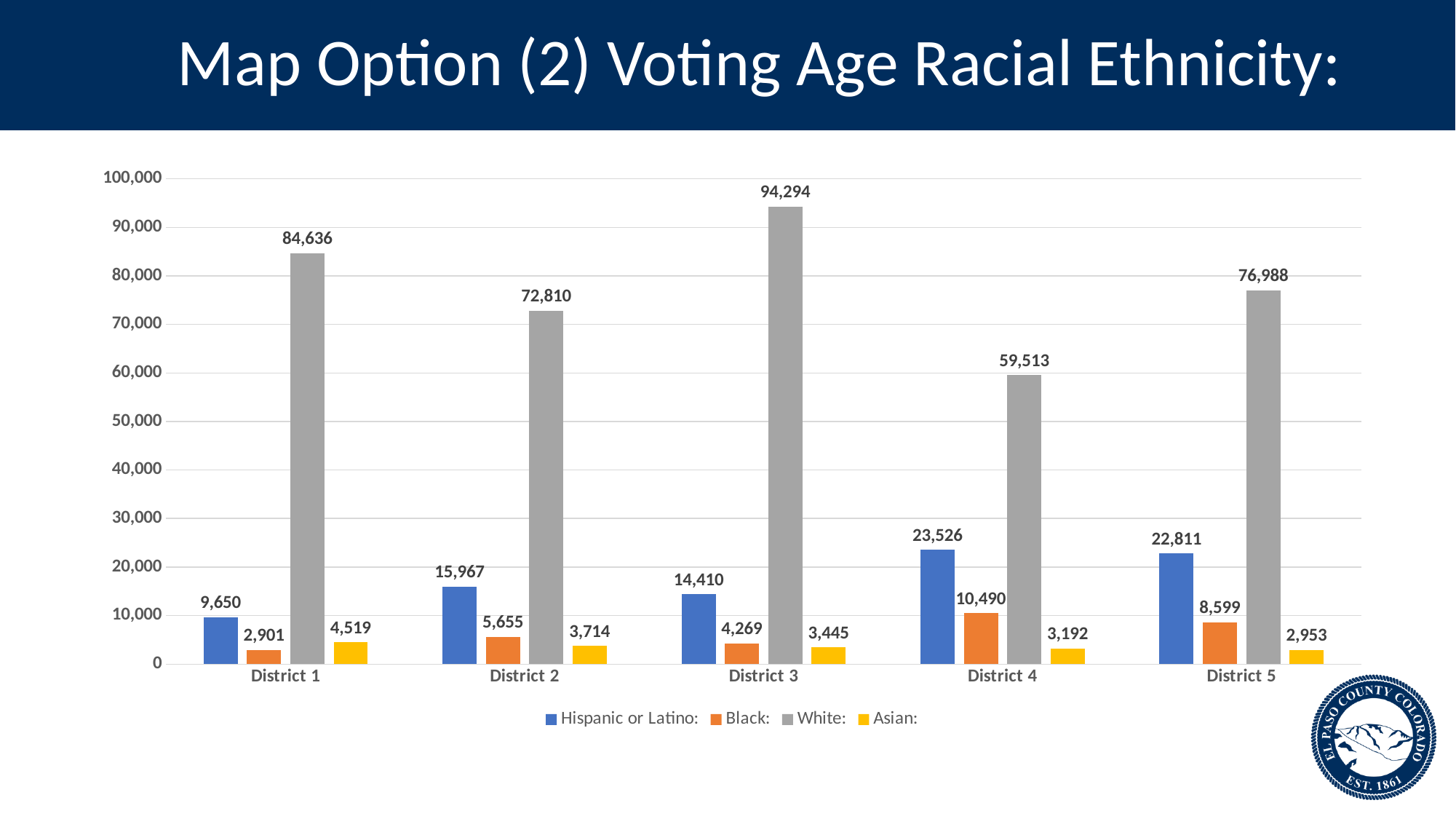
What is the White voting age population in District 3? 94,294 What is the Hispanic or Latino value for District 4? 23,526 Is the White value for District 4 greater or less than 60,000? less How many series does the legend list? 4 What is the difference between the White values for District 3 and District 1? 9,658 Which is larger, the Black value for District 4 or the Black value for District 2? District 4 How many districts are shown on the x axis? 5 Which district has the lowest Asian value? District 5 Which district has the highest White value? District 3 What is the Black value for District 5? 8,599 What kind of chart is shown on the slide? bar chart What is the Asian value for District 1? 4,519